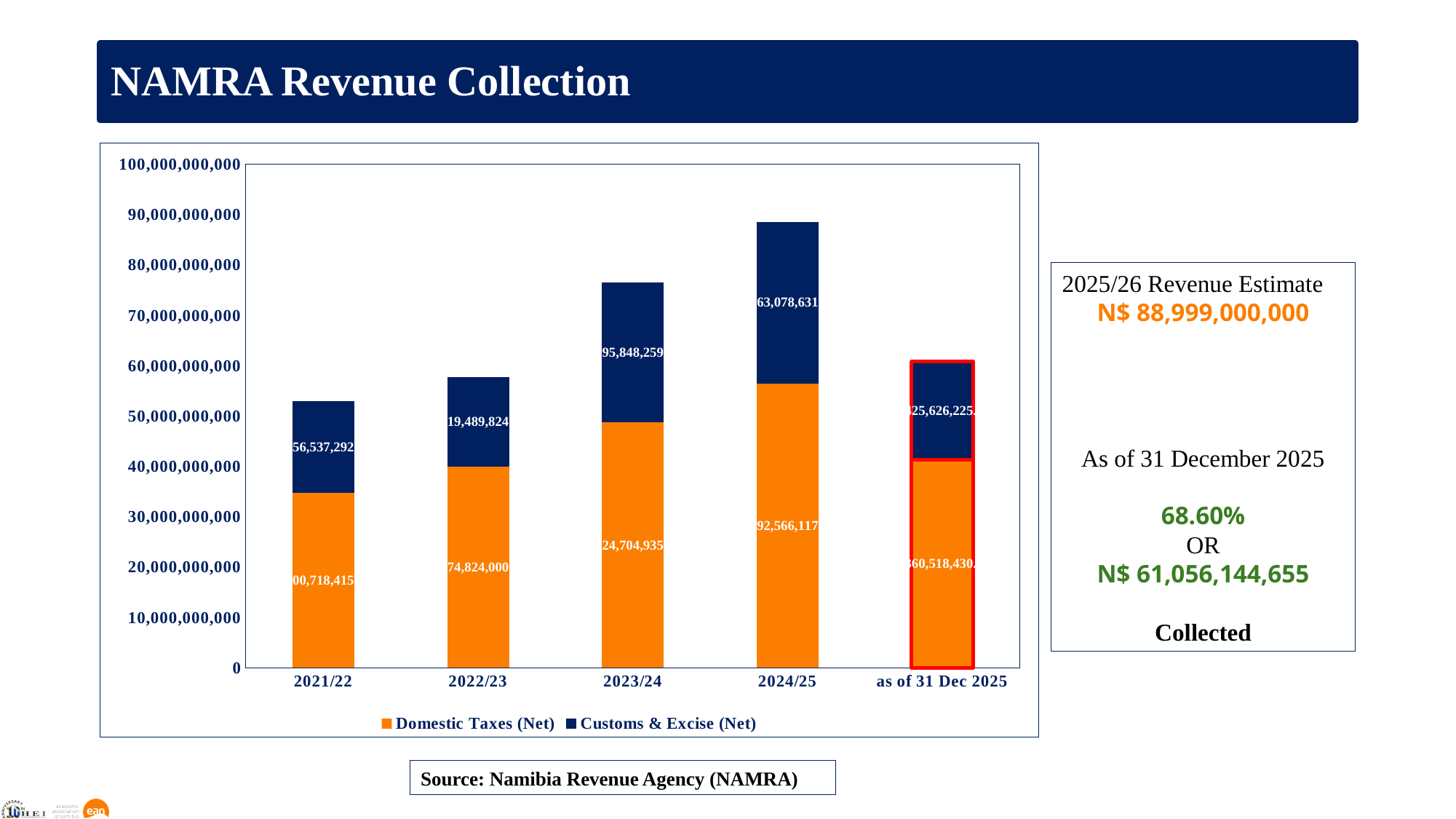
Which period has the highest total revenue bar? 2024/25 Which total bar is taller, 2022/23 or 2023/24? 2023/24 How many series does the chart legend list? 2 Do the total revenue bars rise or fall from 2021/22 to 2024/25? Rise How many periods are shown along the x axis of the chart? 5 Is the total bar for 2023/24 greater or less than 70,000,000,000? greater Which series is shown in orange in the chart? Domestic Taxes (Net) Which period has the lowest total revenue bar? 2021/22 Which period has the larger Customs & Excise (Net) segment, 2021/22 or 2024/25? 2024/25 What kind of chart is shown on the slide? Stacked bar chart Is the total bar for 2024/25 greater or less than 80,000,000,000? greater Is the Domestic Taxes (Net) value for 2021/22 greater or less than 40,000,000,000? less